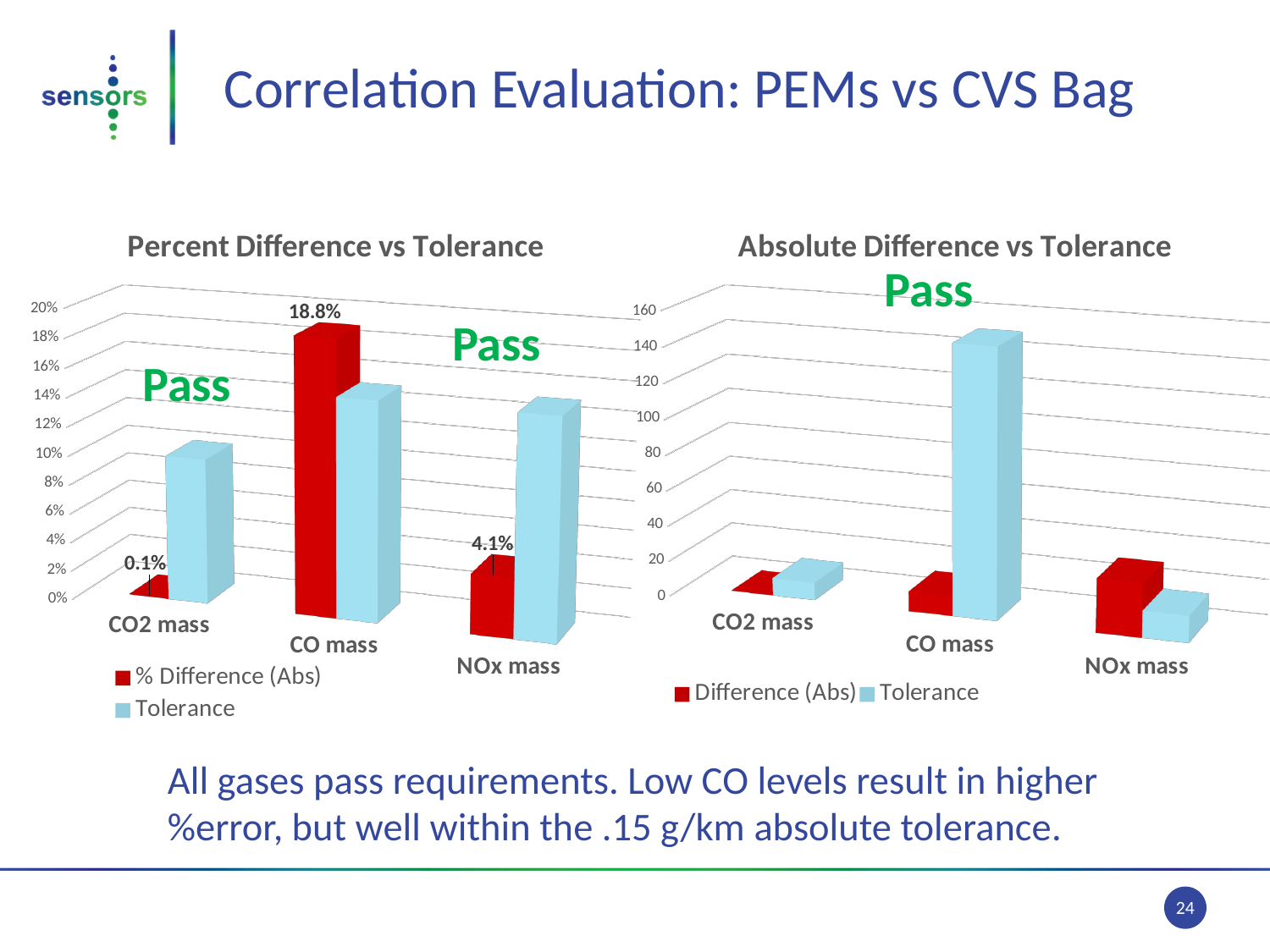
In the Percent Difference vs Tolerance chart, what is the difference between the % Difference (Abs) for CO mass and for NOx mass? 14.7% In the Percent Difference vs Tolerance chart, which category has the highest % Difference (Abs)? CO mass In the Absolute Difference vs Tolerance chart, which category has the highest Tolerance value? CO mass In the Percent Difference vs Tolerance chart, what is the % Difference (Abs) for CO mass? 18.8% In the Percent Difference vs Tolerance chart, for CO mass, which is larger: the % Difference (Abs) bar or the Tolerance bar? % Difference (Abs) In the Percent Difference vs Tolerance chart, which category has the lowest % Difference (Abs)? CO2 mass How many series does the legend of the Absolute Difference vs Tolerance chart list? 2 In the Percent Difference vs Tolerance chart, what is the % Difference (Abs) for NOx mass? 4.1% How many categories are shown on the x axis of the Percent Difference vs Tolerance chart? 3 In the Percent Difference vs Tolerance chart, what is the % Difference (Abs) for CO2 mass? 0.1% In the Absolute Difference vs Tolerance chart, is the Tolerance value for CO mass greater or less than 100? greater What kind of chart is the Absolute Difference vs Tolerance chart? Bar chart